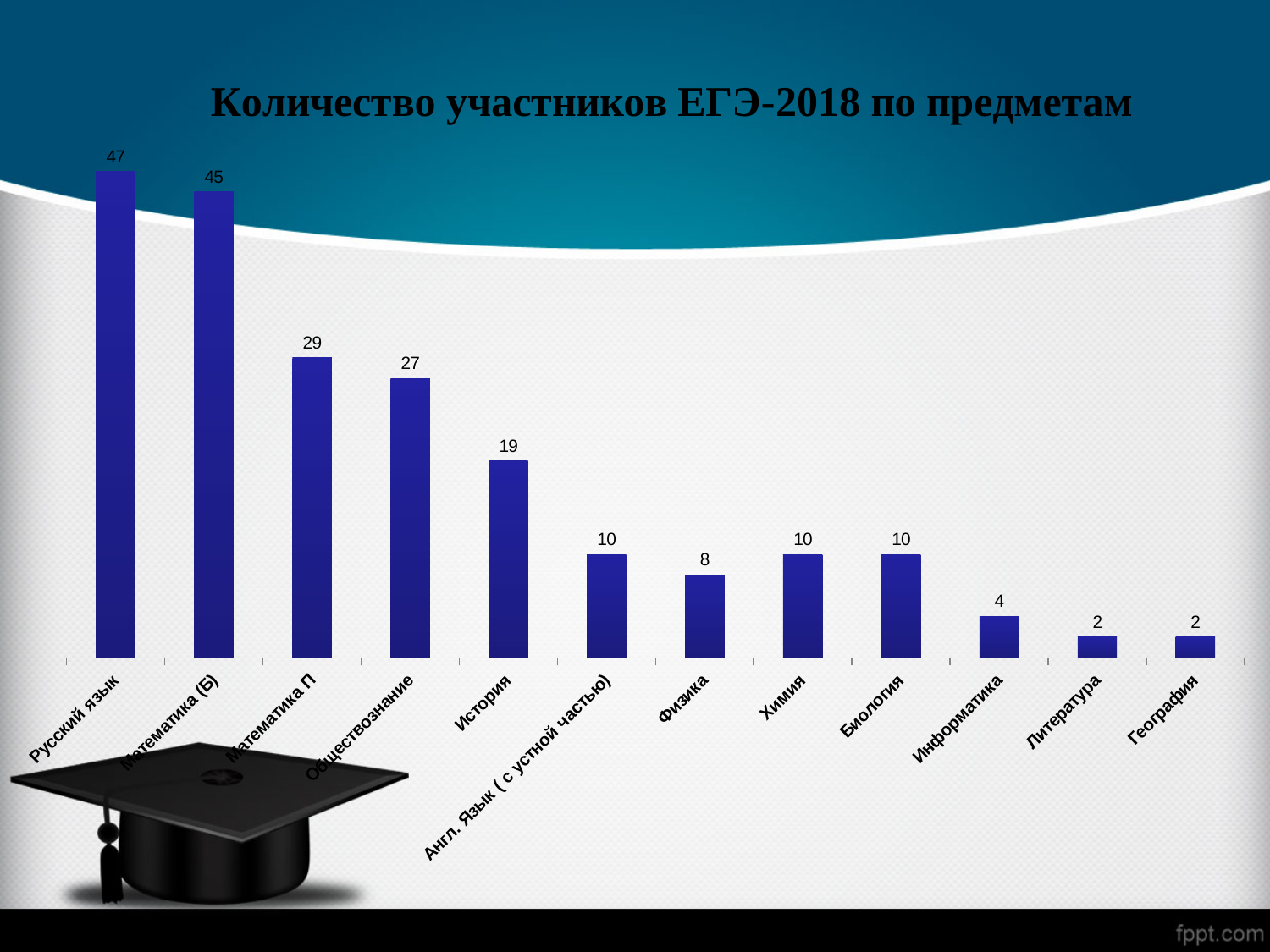
Which subject has the highest number of participants? Русский язык What is the difference between the values for Математика П and Физика? 21 Do the values generally rise or fall from left to right along the x axis? Fall What is the value shown for Обществознание? 27 What kind of chart is shown on the slide? Bar chart How many subjects are shown on the chart? 12 What is the difference between the values for Русский язык and Математика (Б)? 2 Which is larger, the value for Информатика or the value for Литература? Информатика How many participants took Русский язык according to the chart? 47 What is the value shown for История? 19 What is the title of the chart? Количество участников ЕГЭ-2018 по предметам Which is larger, the value for Физика or the value for Химия? Химия